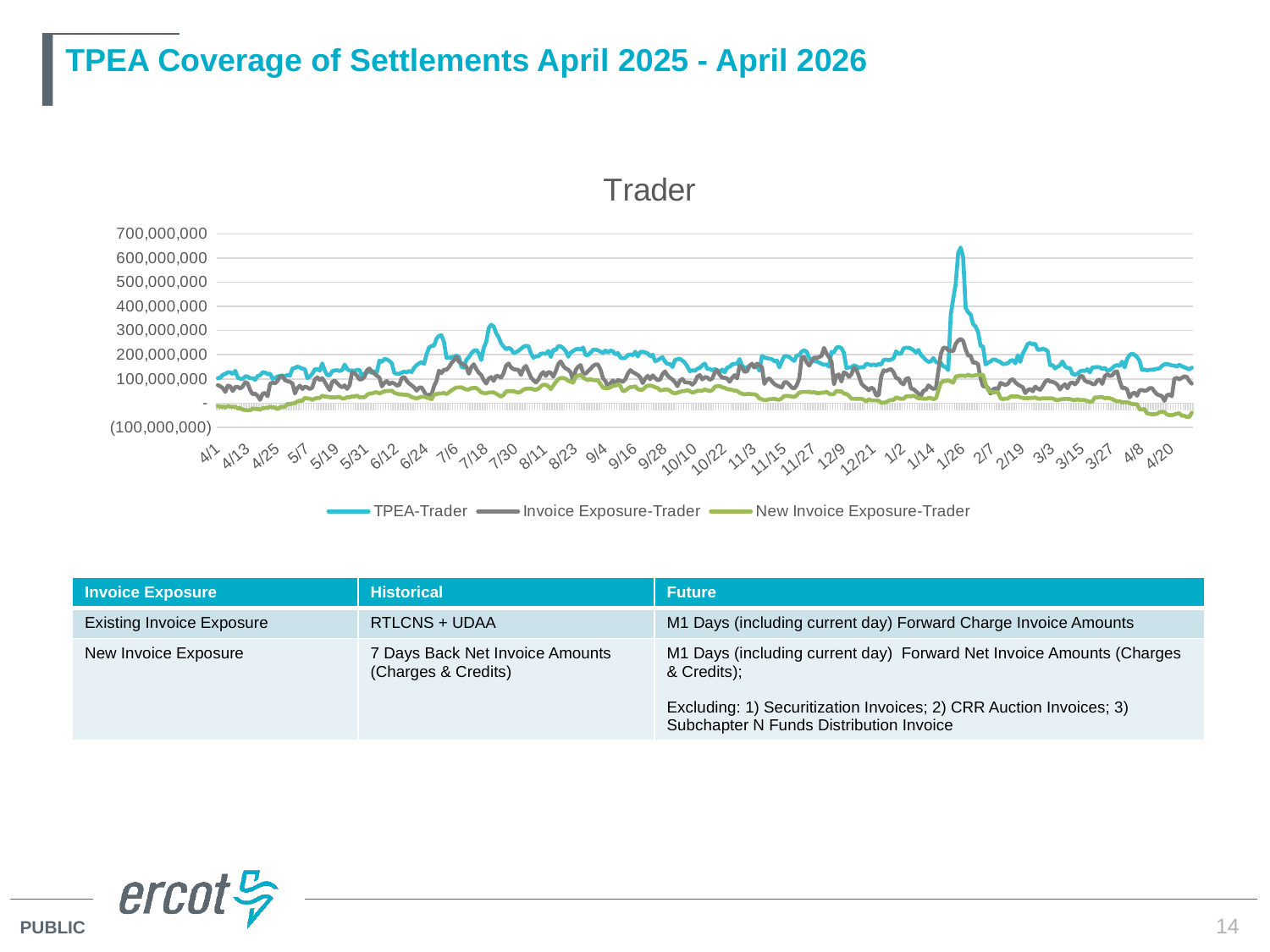
How many series does the legend of the chart list? 3 Is the peak value of TPEA-Trader around late January greater or less than 500,000,000? greater What is the title of the chart? Trader Which series reaches the highest peak in the chart? TPEA-Trader Is the value of New Invoice Exposure-Trader at 4/20 greater or less than 0? less Which series in the chart is drawn in green? New Invoice Exposure-Trader What is the highest value shown on the vertical axis of the chart? 700,000,000 Around 1/26, which is larger: TPEA-Trader or New Invoice Exposure-Trader? TPEA-Trader Which series stays lowest across most of the chart? New Invoice Exposure-Trader Does the New Invoice Exposure-Trader line rise or fall between 3/27 and 4/20? fall What kind of chart is shown on the slide? line chart Is the value of New Invoice Exposure-Trader at 4/1 greater or less than 100,000,000? less